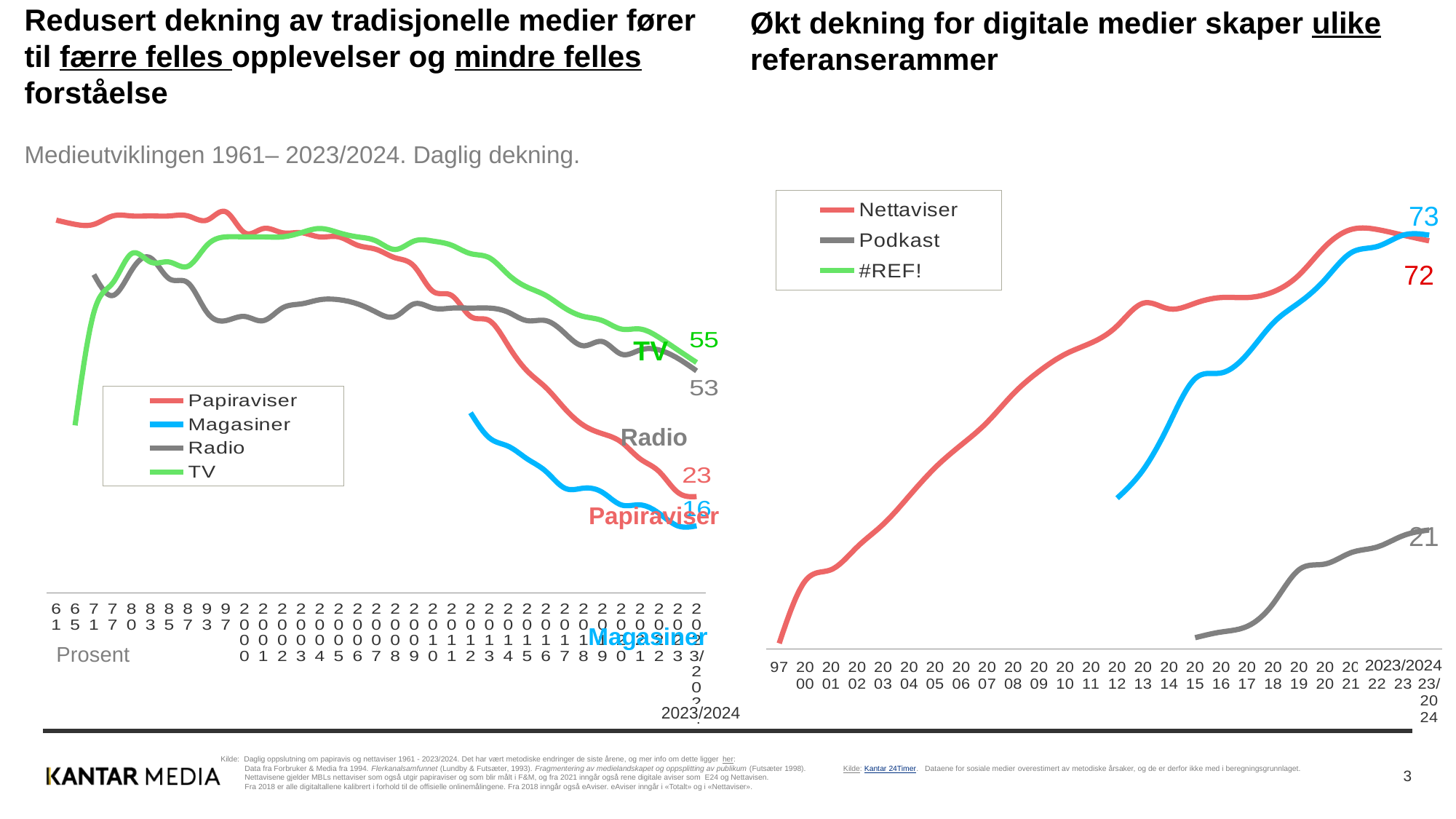
On the left chart (Medieutviklingen 1961– 2023/2024), what is the final value shown for Magasiner in 2023/2024? 16 On the right chart (Økt dekning for digitale medier), what is the final value shown for Podkast in 2023/2024? 21 On the left chart (Medieutviklingen 1961– 2023/2024), what is the difference between the 2023/2024 values for TV and Papiraviser? 32 On the left chart (Medieutviklingen 1961– 2023/2024), does the Papiraviser line rise or fall from 2000 to 2023/2024? fall On the left chart (Medieutviklingen 1961– 2023/2024), which series has the lowest value in 2023/2024? Magasiner On the left chart (Medieutviklingen 1961– 2023/2024), what is the final value shown for Papiraviser in 2023/2024? 23 On the left chart (Medieutviklingen 1961– 2023/2024), which series has the highest value in 2023/2024? TV On the left chart (Medieutviklingen 1961– 2023/2024), what is the final value shown for TV in 2023/2024? 55 On the right chart (Økt dekning for digitale medier), what is the final value shown for Nettaviser in 2023/2024? 72 On the left chart (Medieutviklingen 1961– 2023/2024), how many series does the legend list? 4 On the left chart (Medieutviklingen 1961– 2023/2024), what is the final value shown for Radio in 2023/2024? 53 What kind of chart is the right chart (Økt dekning for digitale medier)? line chart